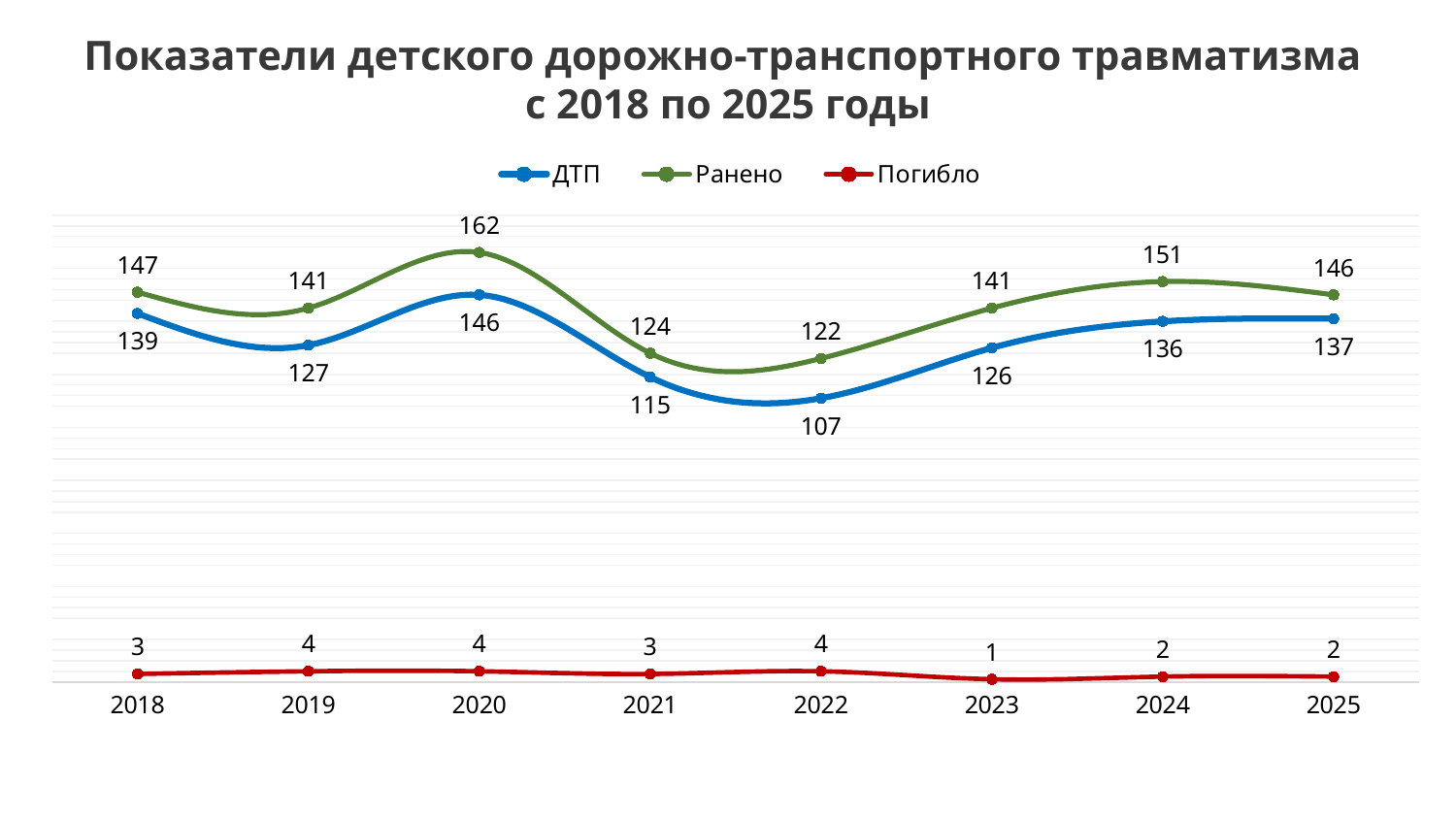
In which year is the Ранено series highest? 2020 What is the value of Ранено in 2025? 146 Does the ДТП series rise or fall from 2022 to 2025? Rise How many years are shown on the x axis? 8 What is the value of Погибло in 2023? 1 Which is larger: ДТП in 2018 or ДТП in 2024? ДТП in 2018 What is the difference between Ранено and ДТП in 2021? 9 What colour is the Погибло line? Red What kind of chart is shown on the slide? Line chart What is the value of ДТП in 2020? 146 In which year is the ДТП series lowest? 2022 How many series does the legend list? 3